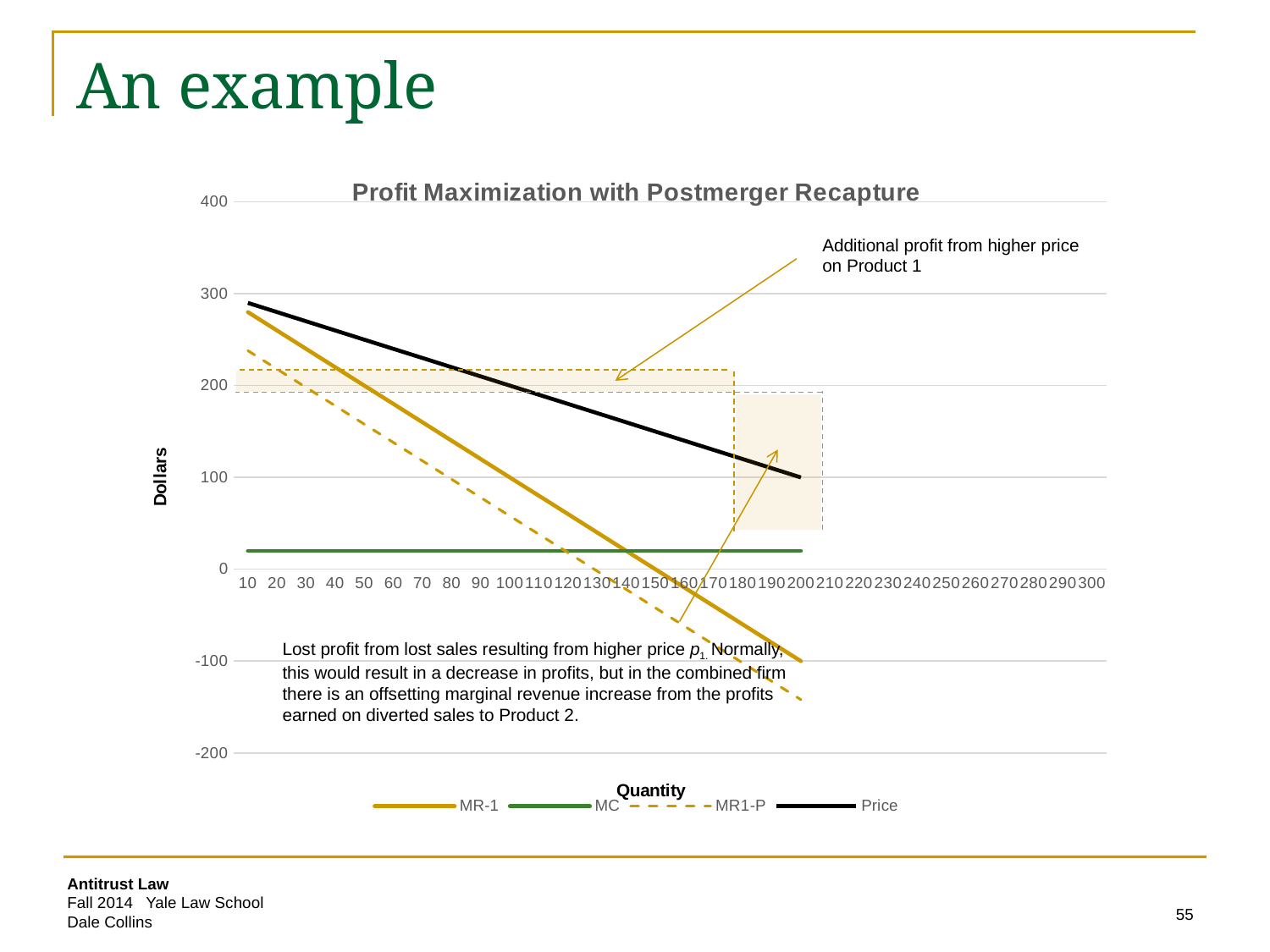
What is the title of the chart? Profit Maximization with Postmerger Recapture How many series does the chart's legend list? 4 Which series has the highest value at Quantity 10? Price What kind of chart is shown on the slide? line chart Is the value of the MC line greater or less than 100? less What is the label on the vertical axis of the chart? Dollars Is the value of the MR1-P line at Quantity 200 greater or less than -100? less Which series has the lowest value at Quantity 200? MR1-P Does the Price line rise or fall as Quantity increases? fall At Quantity 100, which is higher: the Price line or the MR-1 line? Price Does the MR-1 line rise or fall as Quantity increases? fall Is the value of the Price line at Quantity 10 greater or less than 200? greater